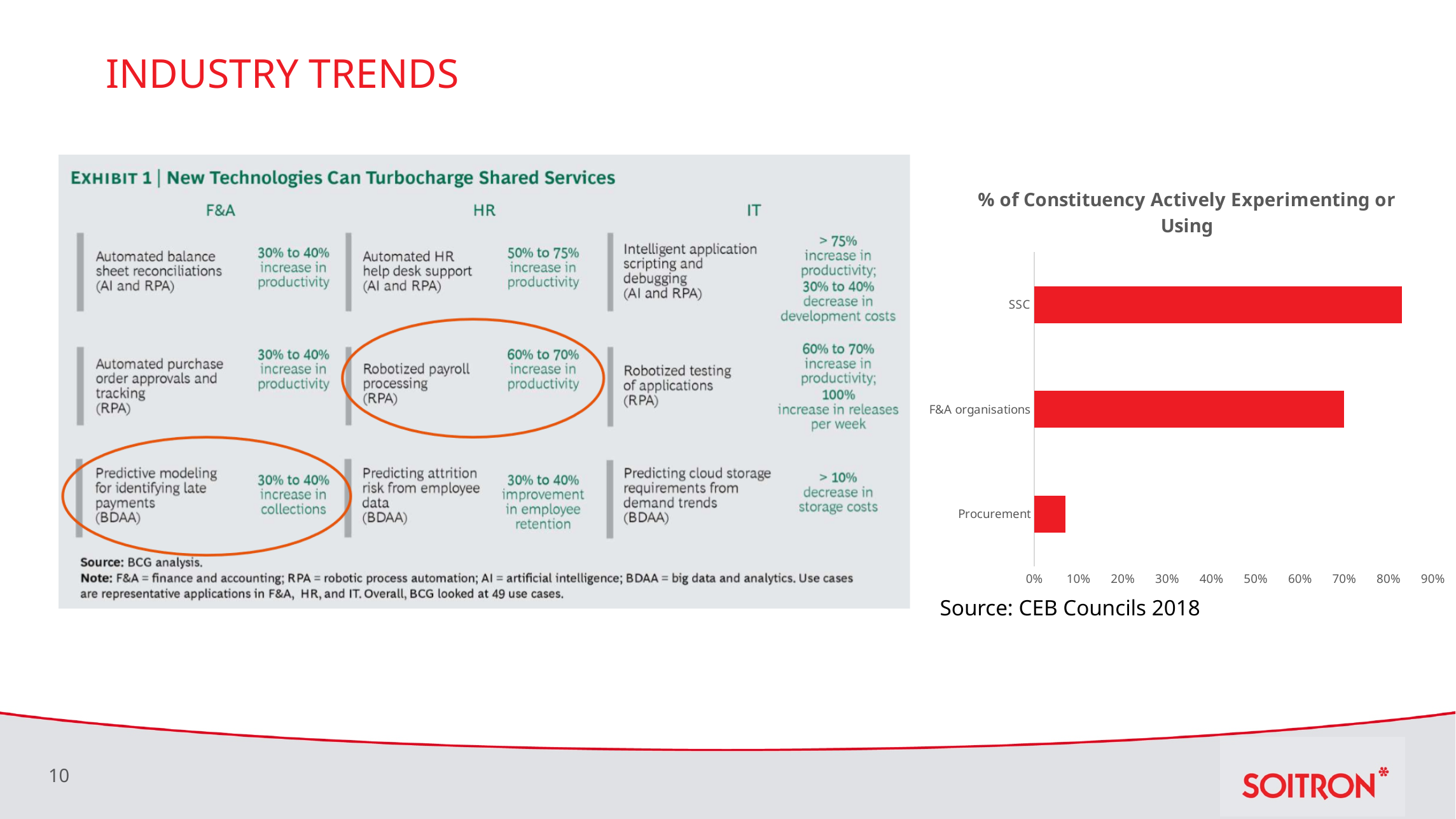
Which category has the lowest value in the '% of Constituency Actively Experimenting or Using' chart? Procurement What is the title of the bar chart on the slide? % of Constituency Actively Experimenting or Using Is the value for Procurement greater or less than 10%? less Which category has the highest value in the '% of Constituency Actively Experimenting or Using' chart? SSC How many categories are plotted in the '% of Constituency Actively Experimenting or Using' chart? 3 Is the value for F&A organisations greater or less than 60%? greater In the '% of Constituency Actively Experimenting or Using' chart, which is larger: Procurement or F&A organisations? F&A organisations In the '% of Constituency Actively Experimenting or Using' chart, which is larger: SSC or F&A organisations? SSC Is the value for SSC greater or less than 80%? greater What kind of chart is shown on the right side of the slide? bar chart What source is cited below the bar chart? CEB Councils 2018